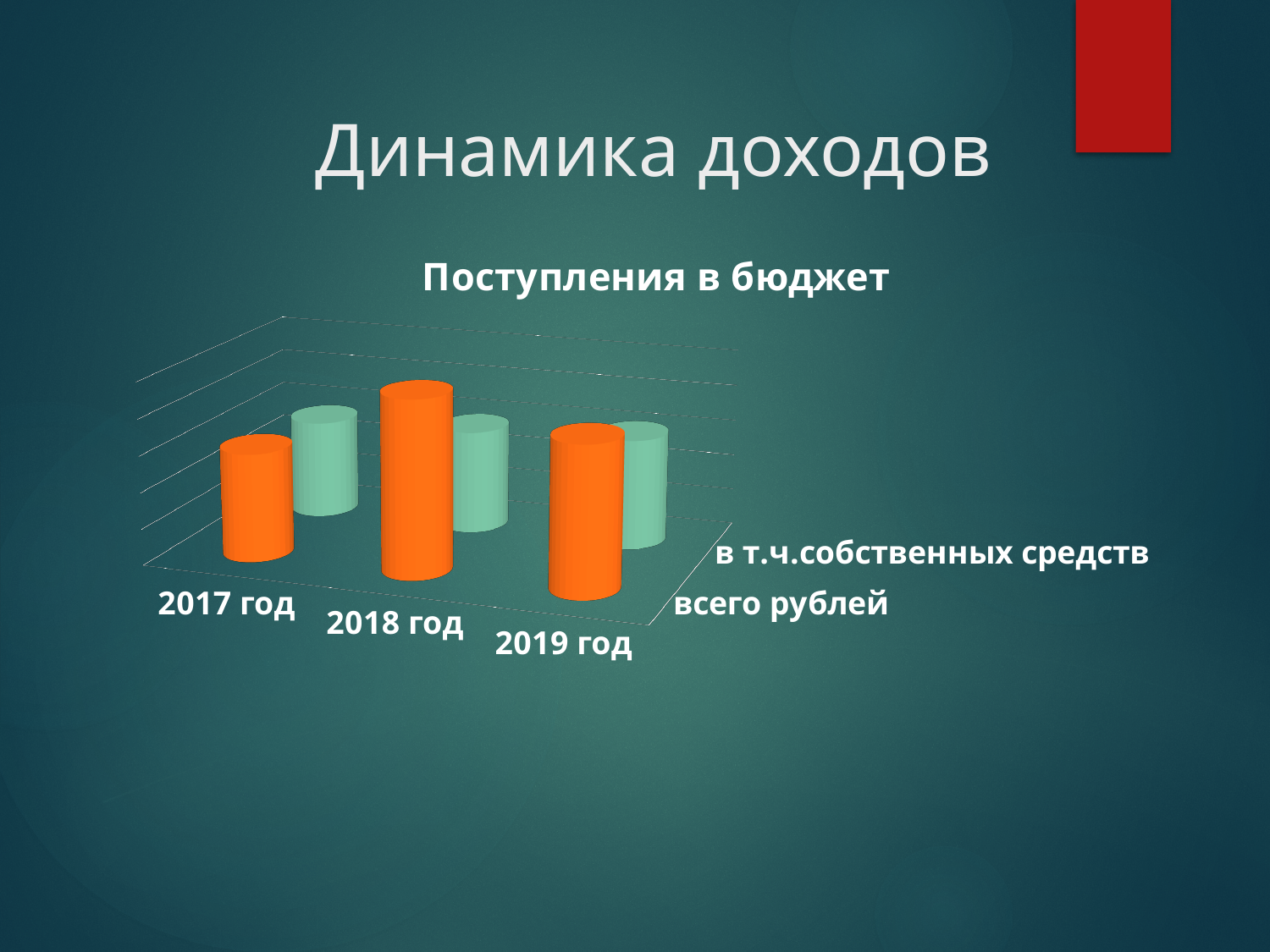
For всего рублей, which is larger: 2018 год or 2019 год? 2018 год What is the title of the chart? Поступления в бюджет Which year has the highest value for всего рублей? 2018 год What kind of chart is shown on the slide? bar chart How many years (categories) are shown on the chart? 3 How many series does the chart show? 2 For всего рублей, which is larger: 2017 год or 2019 год? 2019 год Does the value for всего рублей rise or fall from 2017 год to 2018 год? rise For всего рублей, which is larger: 2017 год or 2018 год? 2018 год Does the value for всего рублей rise or fall from 2018 год to 2019 год? fall Which series is drawn in orange? всего рублей Which year has the lowest value for всего рублей? 2017 год